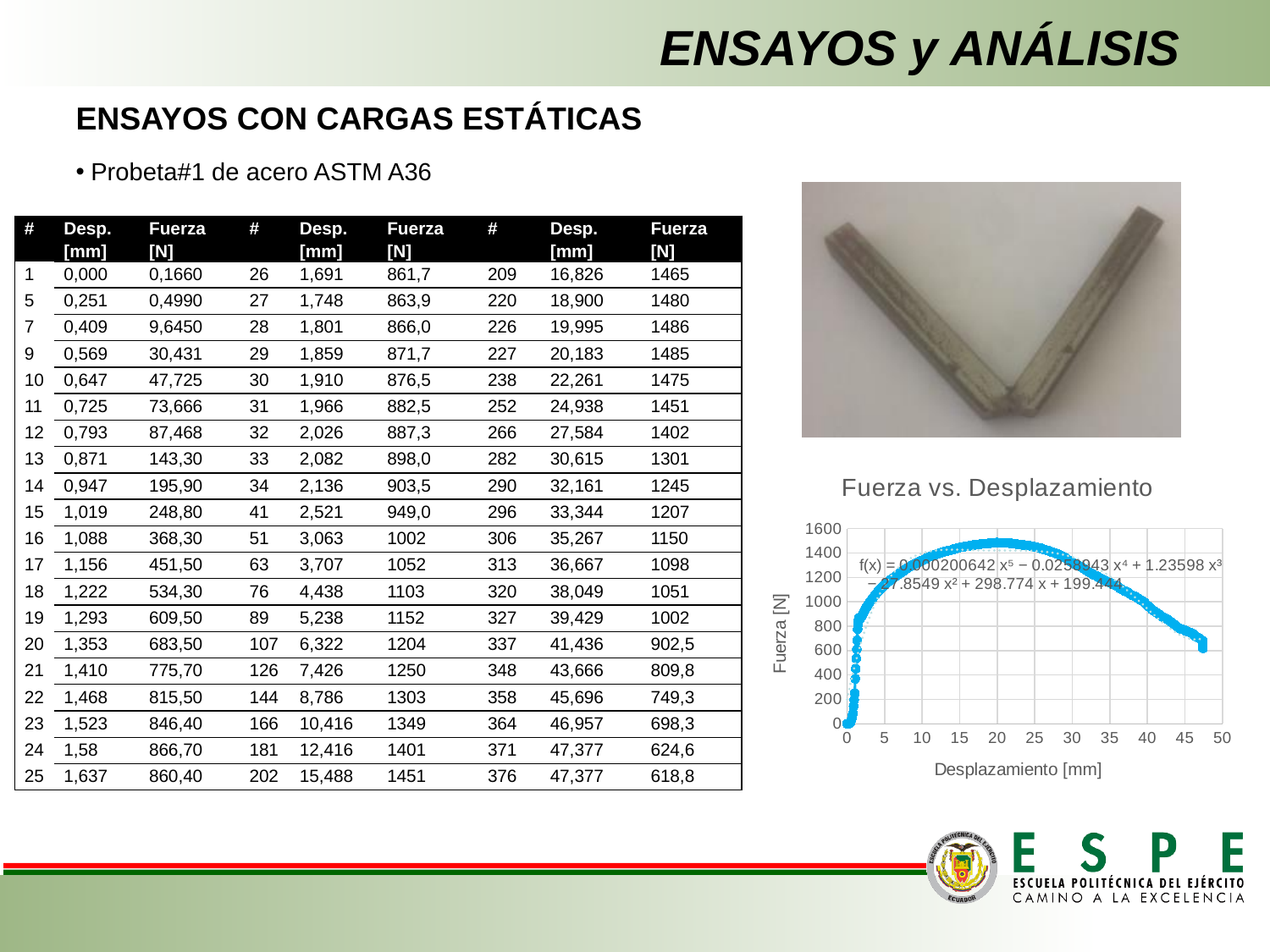
In the 'Fuerza vs. Desplazamiento' chart, does the force rise or fall as displacement increases from 0 to 20 mm? rise In the 'Fuerza vs. Desplazamiento' chart, is the force at a displacement of 30 mm greater or less than 1200? greater What is the title of the chart on the right of the slide? Fuerza vs. Desplazamiento In the 'Fuerza vs. Desplazamiento' chart, does the force rise or fall as displacement increases from 25 mm to 47 mm? fall In the 'Fuerza vs. Desplazamiento' chart, is the force at a displacement of 5 mm greater or less than 1000? greater What is the highest tick value shown on the horizontal axis of the 'Fuerza vs. Desplazamiento' chart? 50 What kind of chart is 'Fuerza vs. Desplazamiento'? scatter chart What is the label of the vertical axis of the 'Fuerza vs. Desplazamiento' chart? Fuerza [N] What is the highest tick value shown on the vertical axis of the 'Fuerza vs. Desplazamiento' chart? 1600 In the 'Fuerza vs. Desplazamiento' chart, is the force at a displacement of 20 mm greater or less than 1400? greater